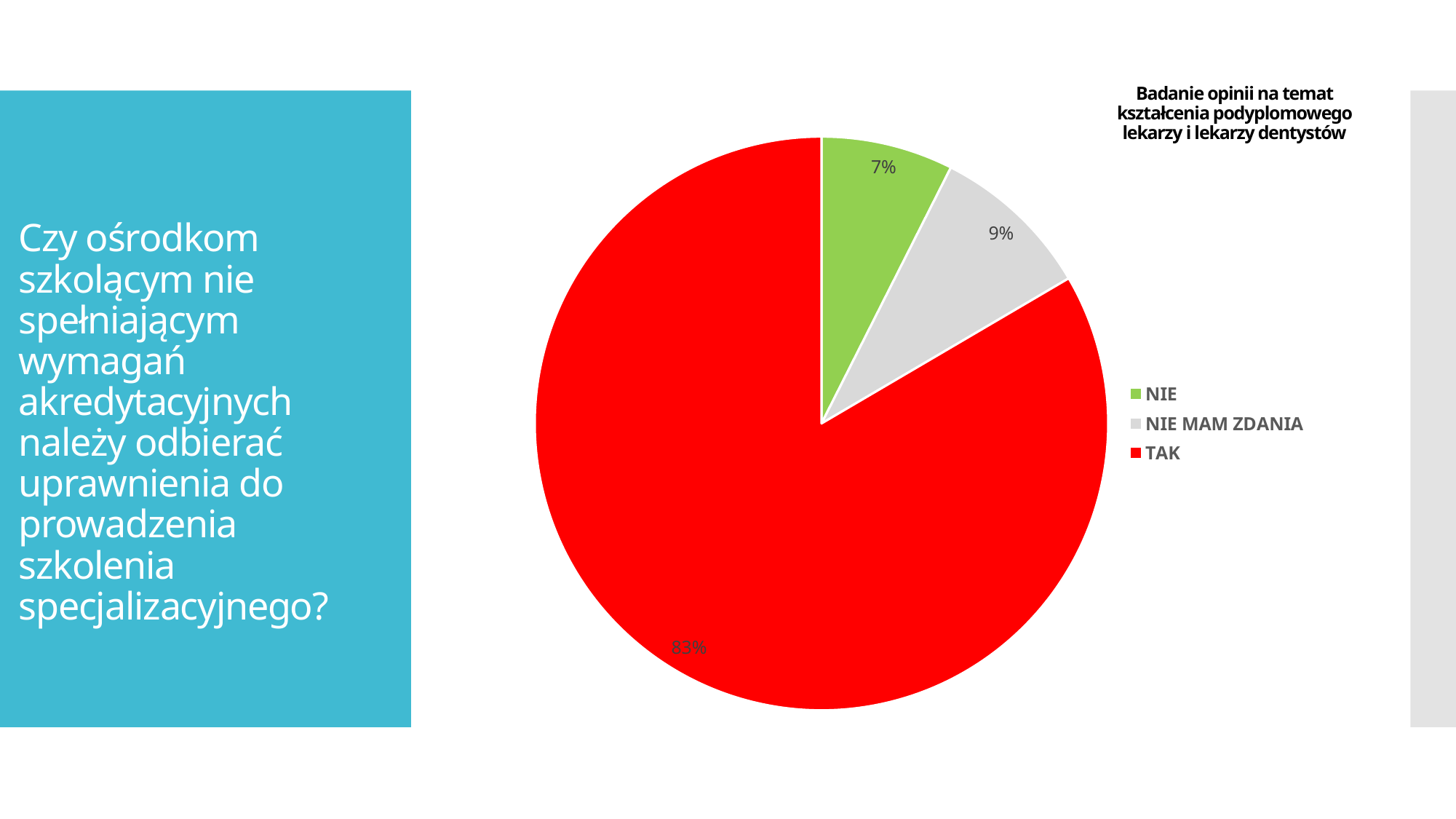
How many categories does the pie chart have? 3 What percentage of respondents answered NIE MAM ZDANIA? 9% What is the difference in percentage points between NIE MAM ZDANIA and NIE? 2 Which legend entry is shown in green? NIE Which is larger, the share for NIE or the share for NIE MAM ZDANIA? NIE MAM ZDANIA What kind of chart is shown on the slide? pie chart Which response has the smallest share of the pie? NIE What colour is the slice for TAK? red What percentage of respondents answered TAK? 83% What is the difference in percentage points between TAK and NIE MAM ZDANIA? 74 Which response has the largest share of the pie? TAK What percentage of respondents answered NIE? 7%